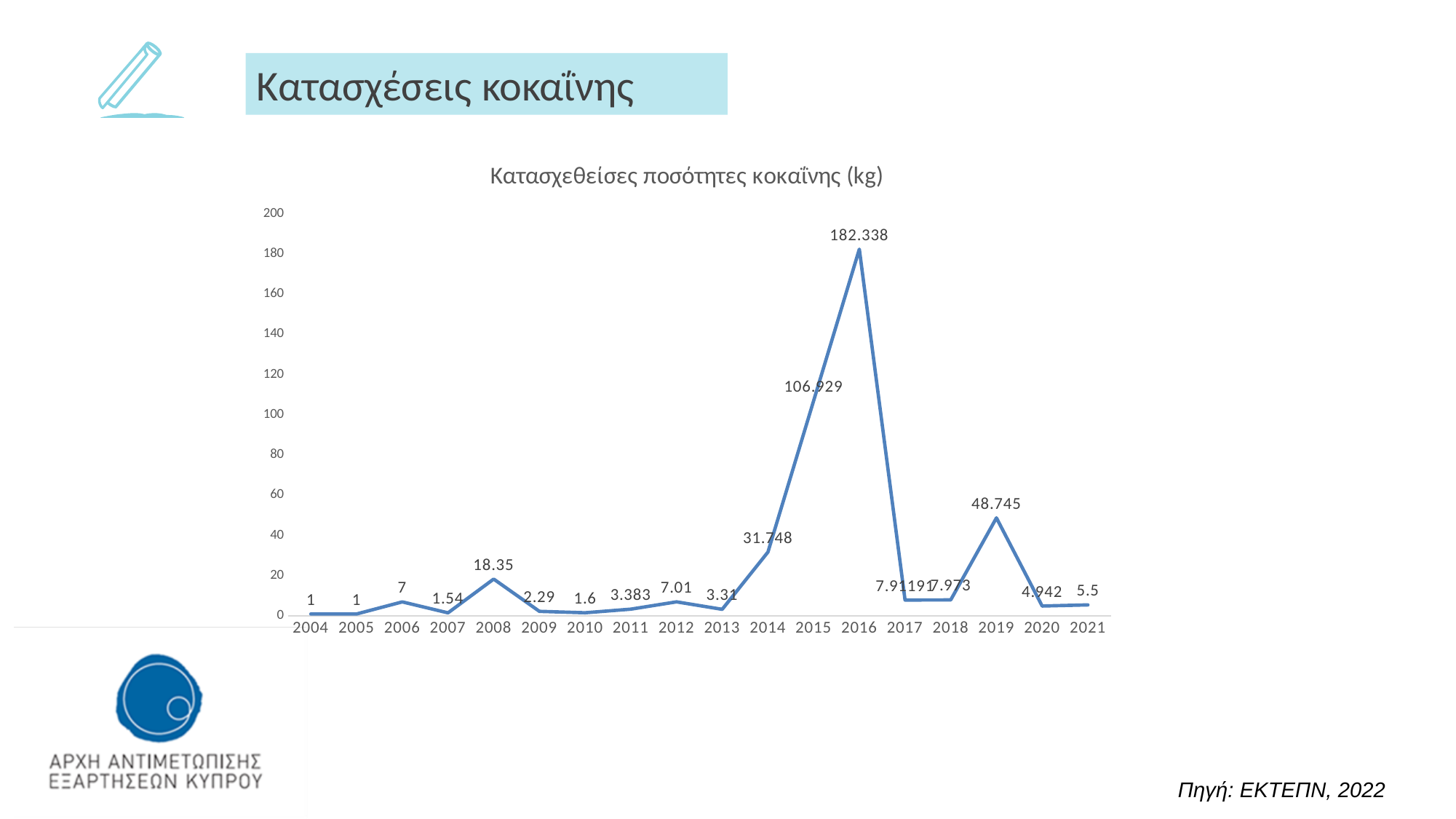
Which year had a larger seized quantity, 2014 or 2019? 2019 What quantity of cocaine (kg) was seized in 2019? 48.745 What quantity of cocaine (kg) was seized in 2016? 182.338 What type of chart is shown on the slide? Line chart What is the difference between the seized quantities in 2016 and 2015? 75.409 What quantity of cocaine (kg) was seized in 2008? 18.35 Did the seized quantity rise or fall from 2014 to 2016? Rise What quantity of cocaine (kg) was seized in 2015? 106.929 In which year was the seized quantity of cocaine highest? 2016 What is the title of the chart? Κατασχεθείσες ποσότητες κοκαΐνης (kg) How many years are plotted on the x axis? 18 What quantity of cocaine (kg) was seized in 2021? 5.5